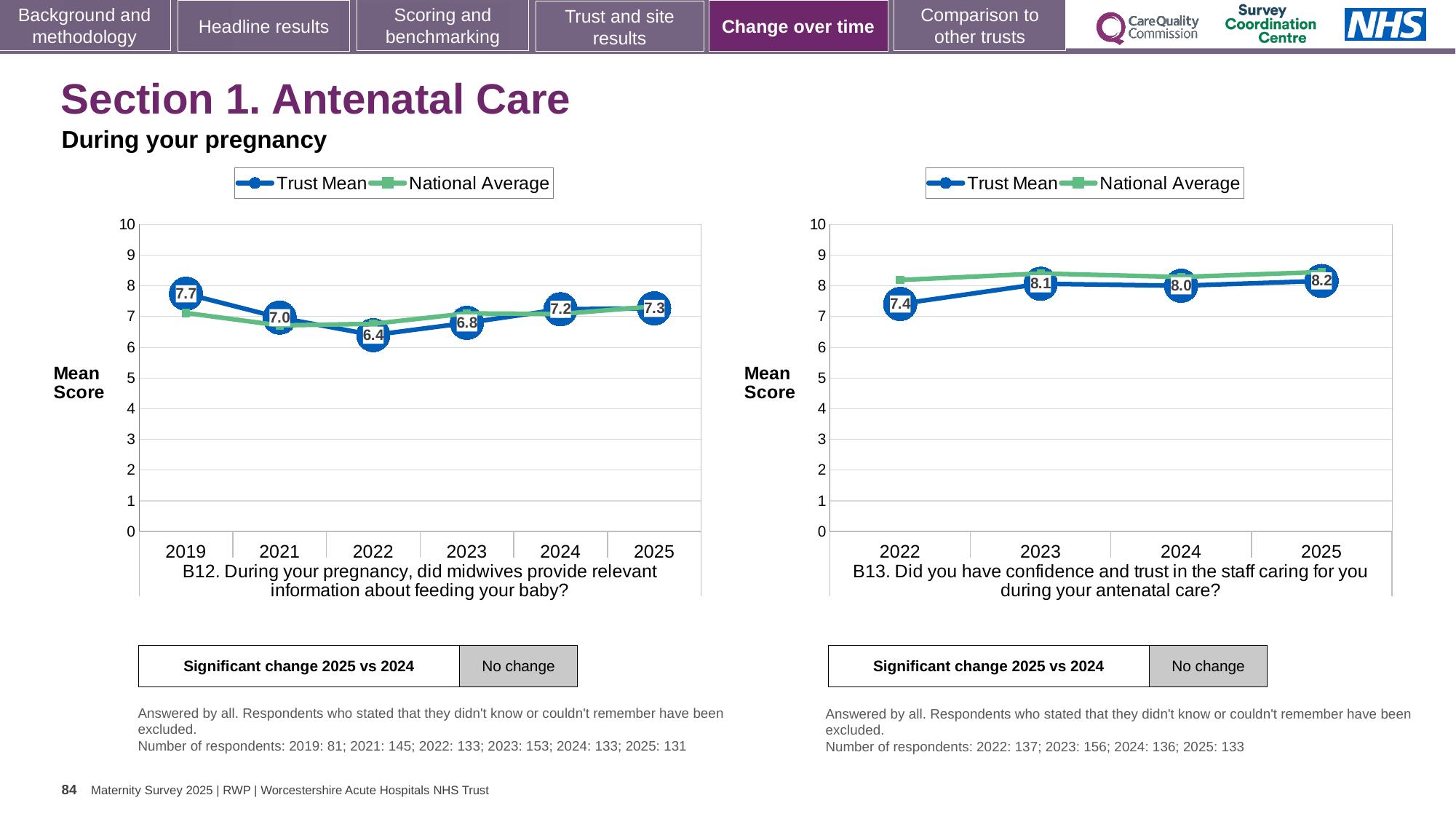
In the B12 chart (left), how many years are shown on the x axis? 6 In the B12 chart (left), which year has the lowest Trust Mean? 2022 In the B12 chart (left), what is the Trust Mean for 2019? 7.7 How many series does the legend of the B13 chart (right) list? 2 In the B12 chart (left), which year has the highest Trust Mean? 2019 In the B13 chart (right), which year has the lowest Trust Mean? 2022 In the B13 chart (right), is the Trust Mean for 2022 larger or smaller than the Trust Mean for 2023? smaller What kind of chart is the B12 chart (left)? Line chart In the B13 chart (right), is the National Average for 2022 greater or less than 7? greater In the B13 chart (right), what is the Trust Mean for 2025? 8.2 In the B12 chart (left), what is the difference between the Trust Mean in 2019 and in 2022? 1.3 In the B12 chart (left), what is the Trust Mean for 2022? 6.4